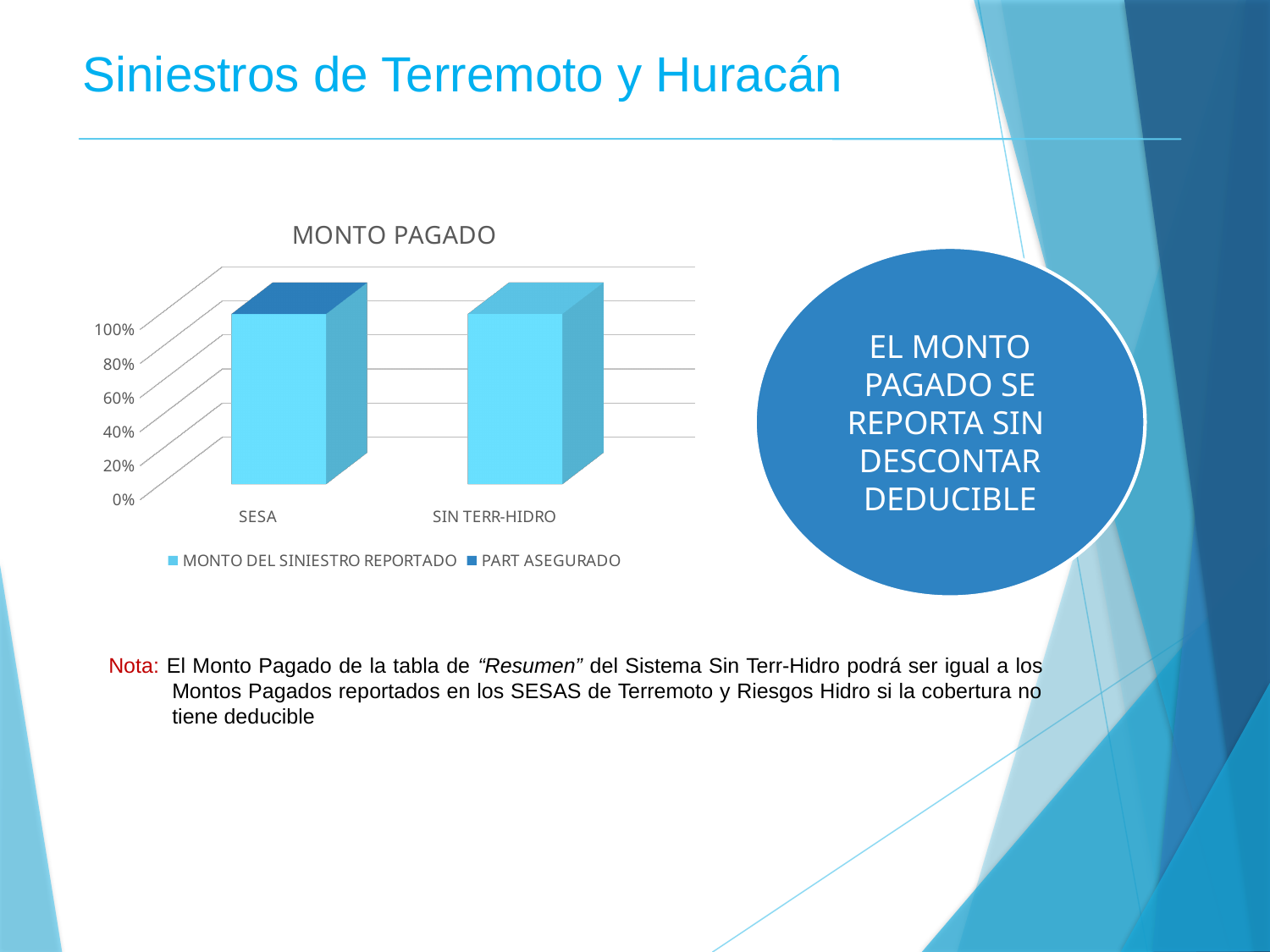
What kind of chart is shown on the slide? bar chart Is the value for SESA greater or less than 80%? greater How many categories are shown on the x axis of the chart? 2 Is the value for SIN TERR-HIDRO greater or less than 40%? greater What is the highest value shown on the y axis of the chart? 100% What is the title of the chart? MONTO PAGADO Is the value for SESA greater or less than 60%? greater What are the two categories shown on the x axis of the chart? SESA and SIN TERR-HIDRO How many series does the chart legend list? 2